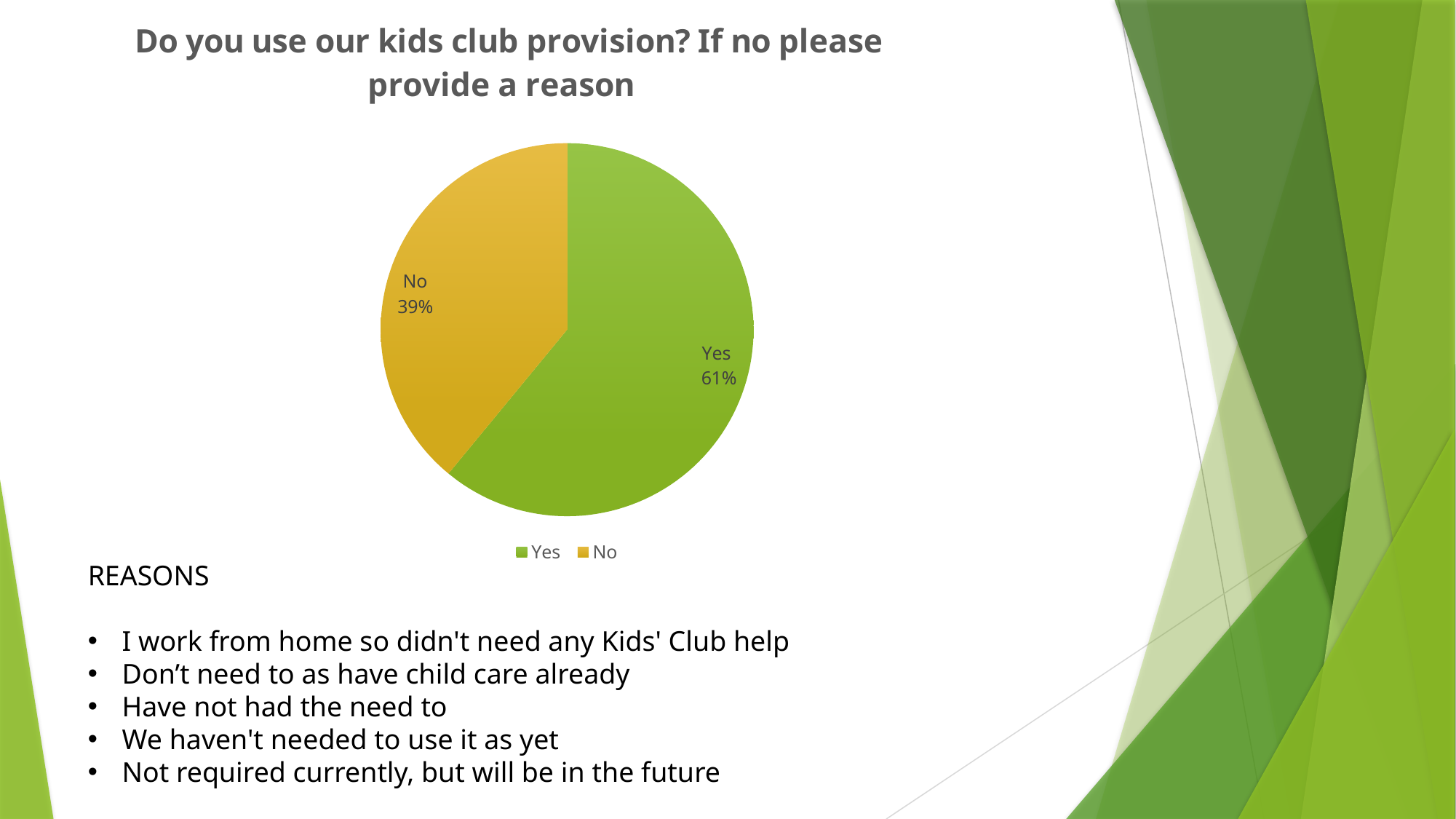
What share of the pie does the Yes slice represent? 61% What percentage of respondents answered Yes? 61% How many entries does the legend list? 2 What colour is the No slice? yellow/gold Which response has the smallest share of the pie? No What is the difference in percentage points between the Yes and No slices? 22 Which response has the largest share of the pie? Yes What percentage of respondents answered No? 39% What kind of chart is shown on the slide? pie chart How many slices does the pie chart have? 2 What is the title of the chart? Do you use our kids club provision? If no please provide a reason Which slice is larger, Yes or No? Yes